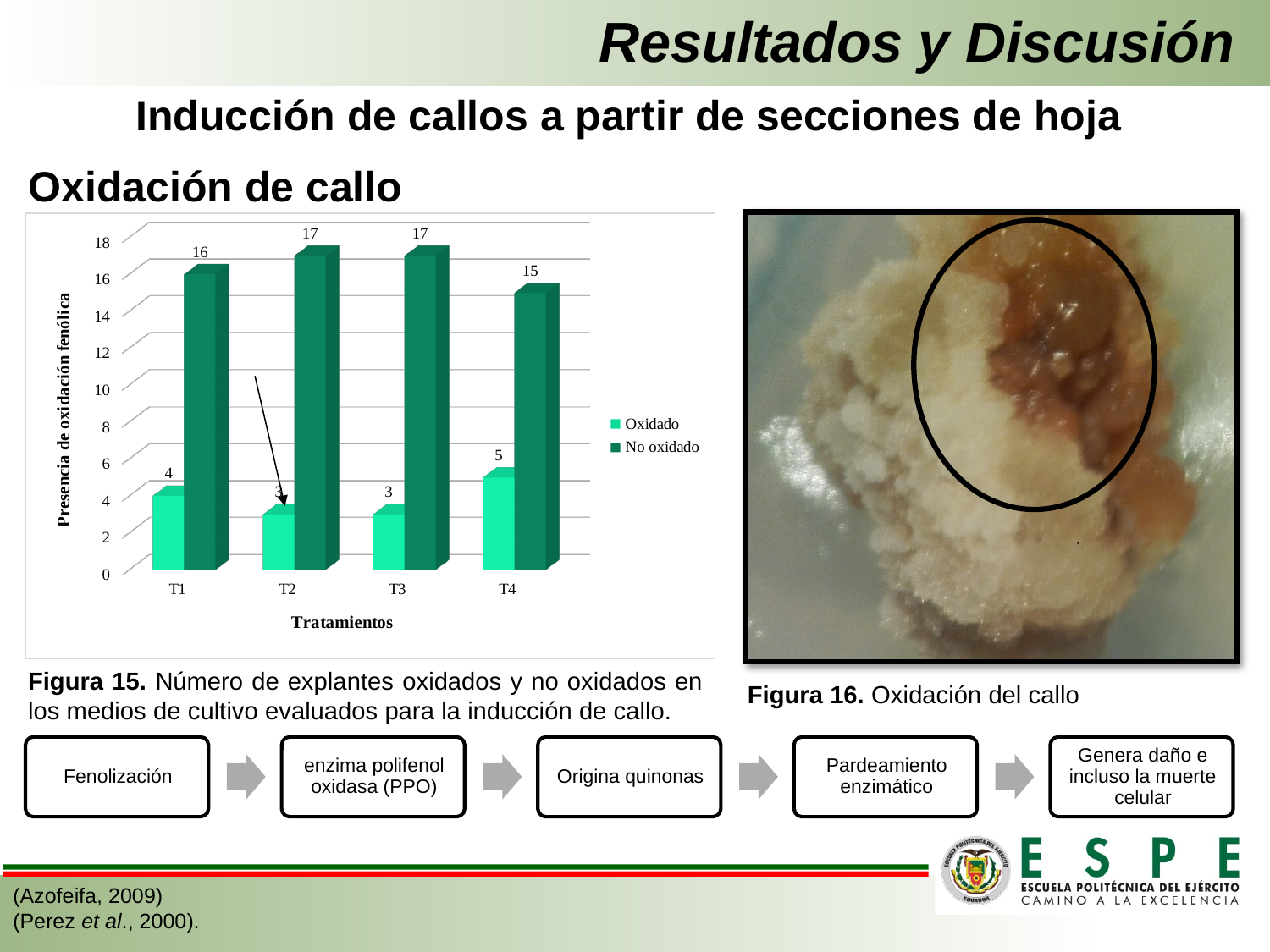
How many series does the legend list? 2 Which treatment has the highest Oxidado value? T4 What is the difference between the No oxidado and Oxidado values at T1? 12 What is the value for Oxidado at T4? 5 What kind of chart is shown? Bar chart How many treatments are shown on the x axis? 4 Which treatment has the lowest No oxidado value? T4 What is the label of the y axis? Presencia de oxidación fenólica What is the value for Oxidado at T3? 3 What is the value for No oxidado at T1? 16 Which is larger, the Oxidado value at T1 or the Oxidado value at T4? T4 What is the value for No oxidado at T4? 15